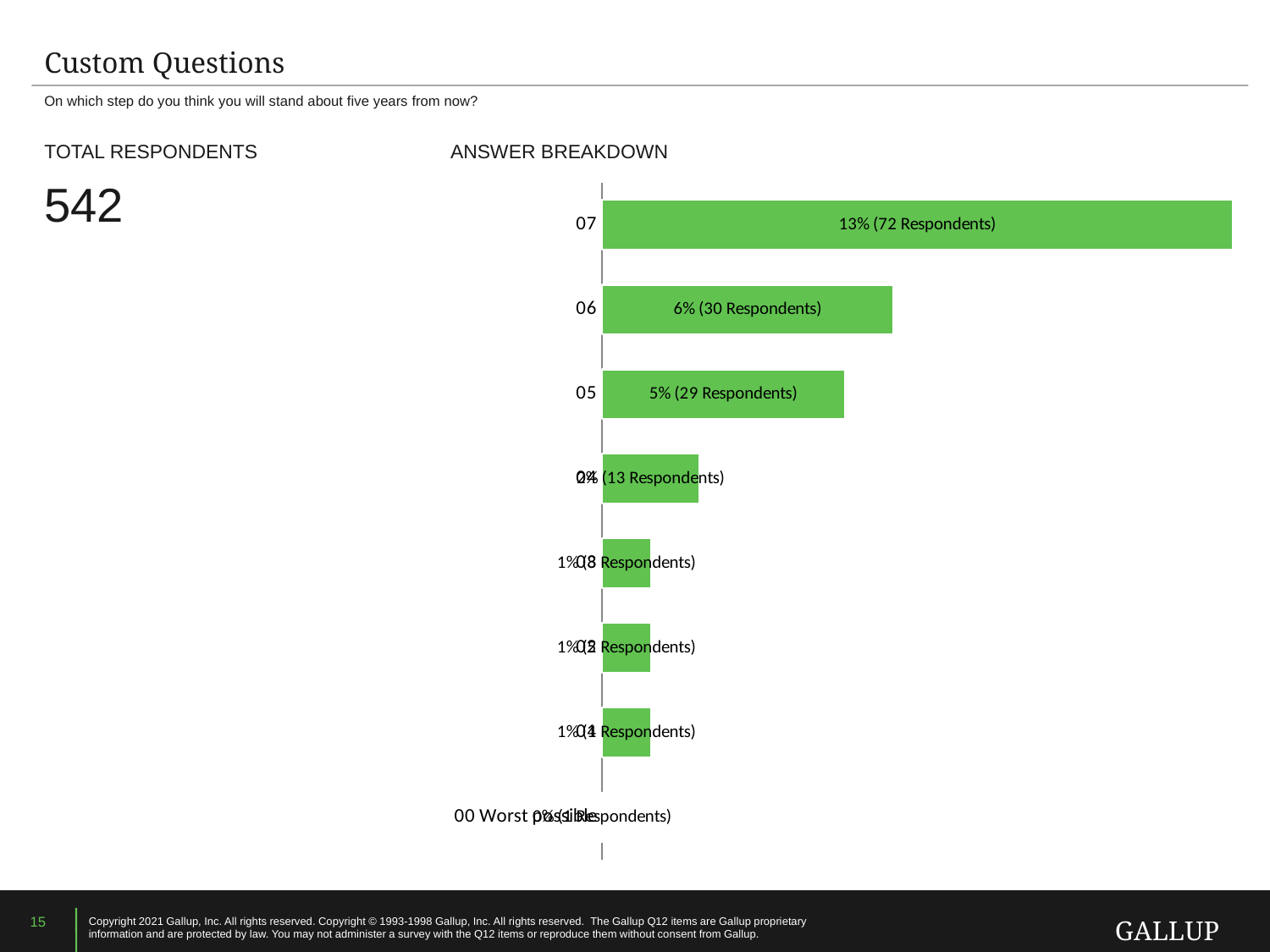
What is the value shown for step 07 in the Answer Breakdown chart? 13% (72 Respondents) How many step categories are listed on the Answer Breakdown chart? 8 What is the value shown for step 06 in the Answer Breakdown chart? 6% (30 Respondents) How many more respondents chose step 06 than step 05? 1 How many more respondents chose step 07 than step 06? 42 What kind of chart is used for the Answer Breakdown? Bar chart Which has more respondents, step 06 or step 05? 06 What is the total number of respondents shown on the slide? 542 How many respondents chose step 04 in the Answer Breakdown chart? 13 What is the value shown for step 05 in the Answer Breakdown chart? 5% (29 Respondents) Which step has the highest share of respondents in the Answer Breakdown chart? 07 What is the heading above the chart on the slide? ANSWER BREAKDOWN